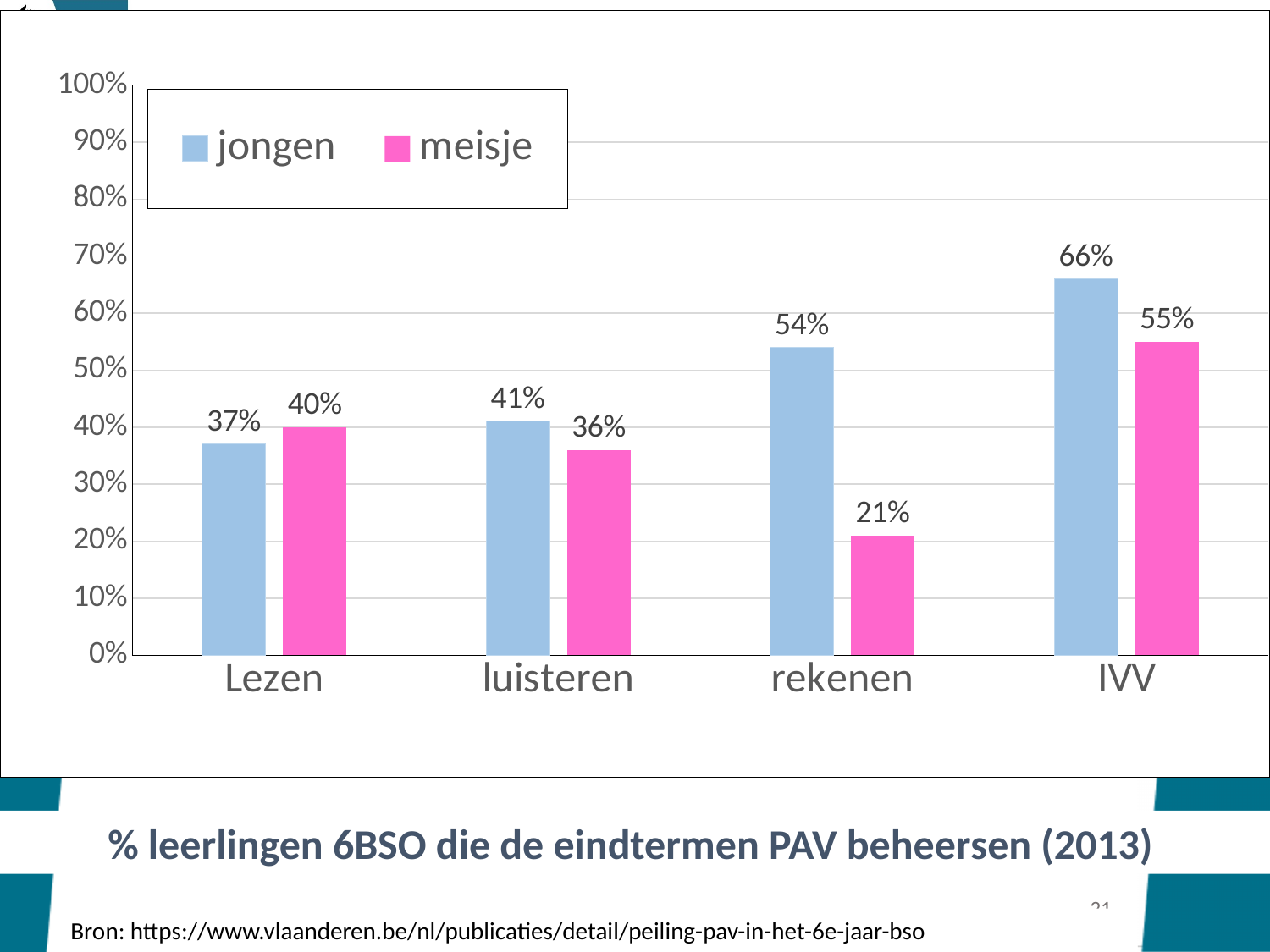
In the Lezen category, which series has the larger value, jongen or meisje? meisje What is the value for meisje in the rekenen category? 21% Which category has the highest value for jongen? IVV What colour are the bars for the meisje series? pink What is the difference between the jongen and meisje values in the rekenen category? 33% How many categories are shown on the x axis? 4 How many series does the legend list? 2 Is the value for jongen in the luisteren category greater or less than 50%? less What is the value for meisje in the IVV category? 55% Which category has the lowest value for meisje? rekenen What kind of chart is shown on the slide? bar chart What is the value for jongen in the Lezen category? 37%